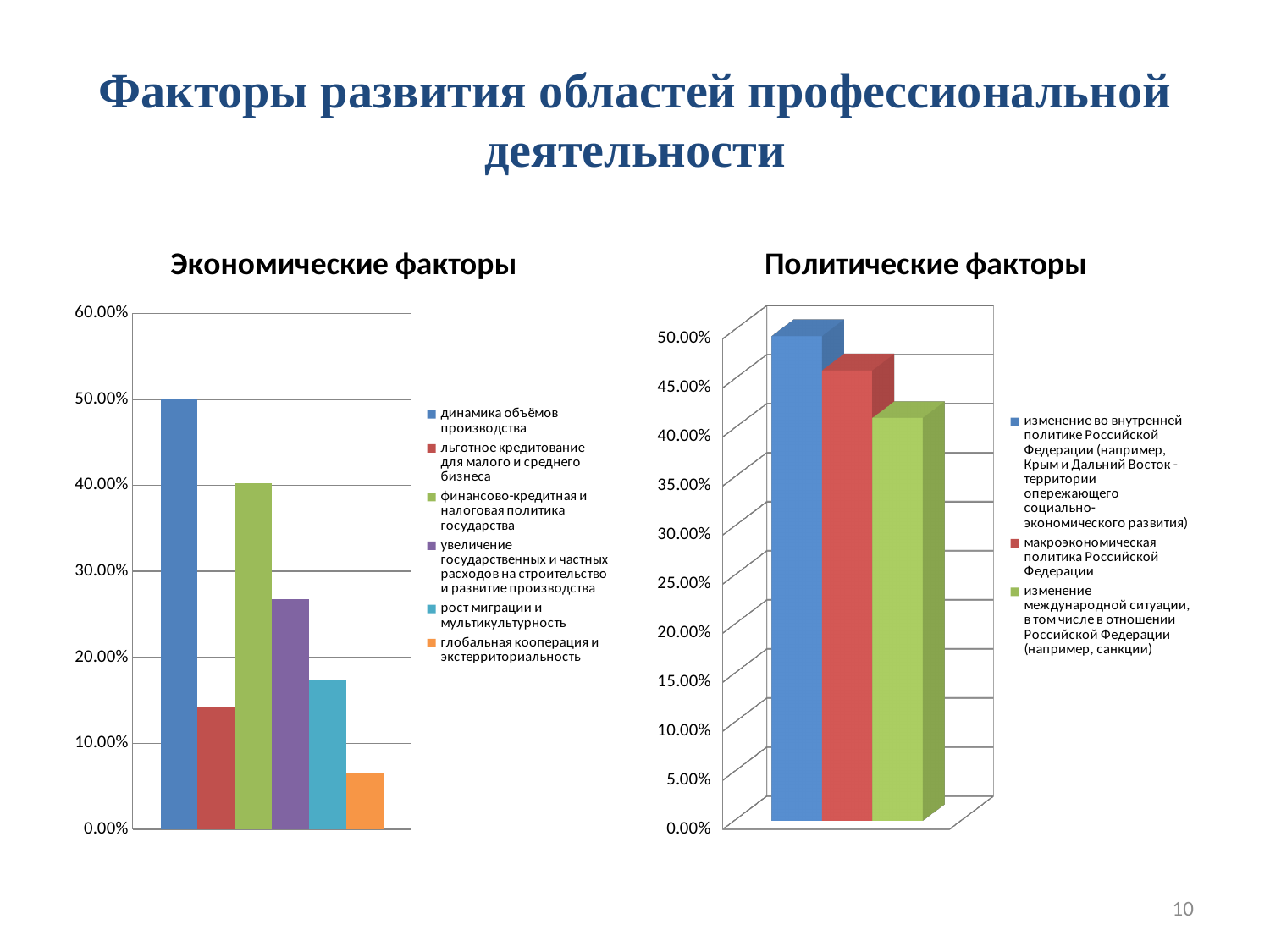
How many series does the legend of the chart titled "Экономические факторы" list? 6 On the chart titled "Экономические факторы", which factor has the lowest value? глобальная кооперация и экстерриториальность On the chart titled "Экономические факторы", is the value for "льготное кредитование для малого и среднего бизнеса" greater or less than 20.00%? less On the chart titled "Экономические факторы", which is larger: "финансово-кредитная и налоговая политика государства" or "рост миграции и мультикультурность"? финансово-кредитная и налоговая политика государства On the chart titled "Экономические факторы", is the value for "глобальная кооперация и экстерриториальность" greater or less than 10.00%? less On the chart titled "Политические факторы", which factor has the lowest value? изменение международной ситуации, в том числе в отношении Российской Федерации (например, санкции) On the chart titled "Экономические факторы", is the value for "увеличение государственных и частных расходов на строительство и развитие производства" greater or less than 20.00%? greater What kind of chart is the chart titled "Политические факторы"? bar chart On the chart titled "Экономические факторы", which factor has the highest value? динамика объёмов производства On the chart titled "Политические факторы", which factor has the highest value? изменение во внутренней политике Российской Федерации (например, Крым и Дальний Восток - территории опережающего социально-экономического развития) How many series does the legend of the chart titled "Политические факторы" list? 3